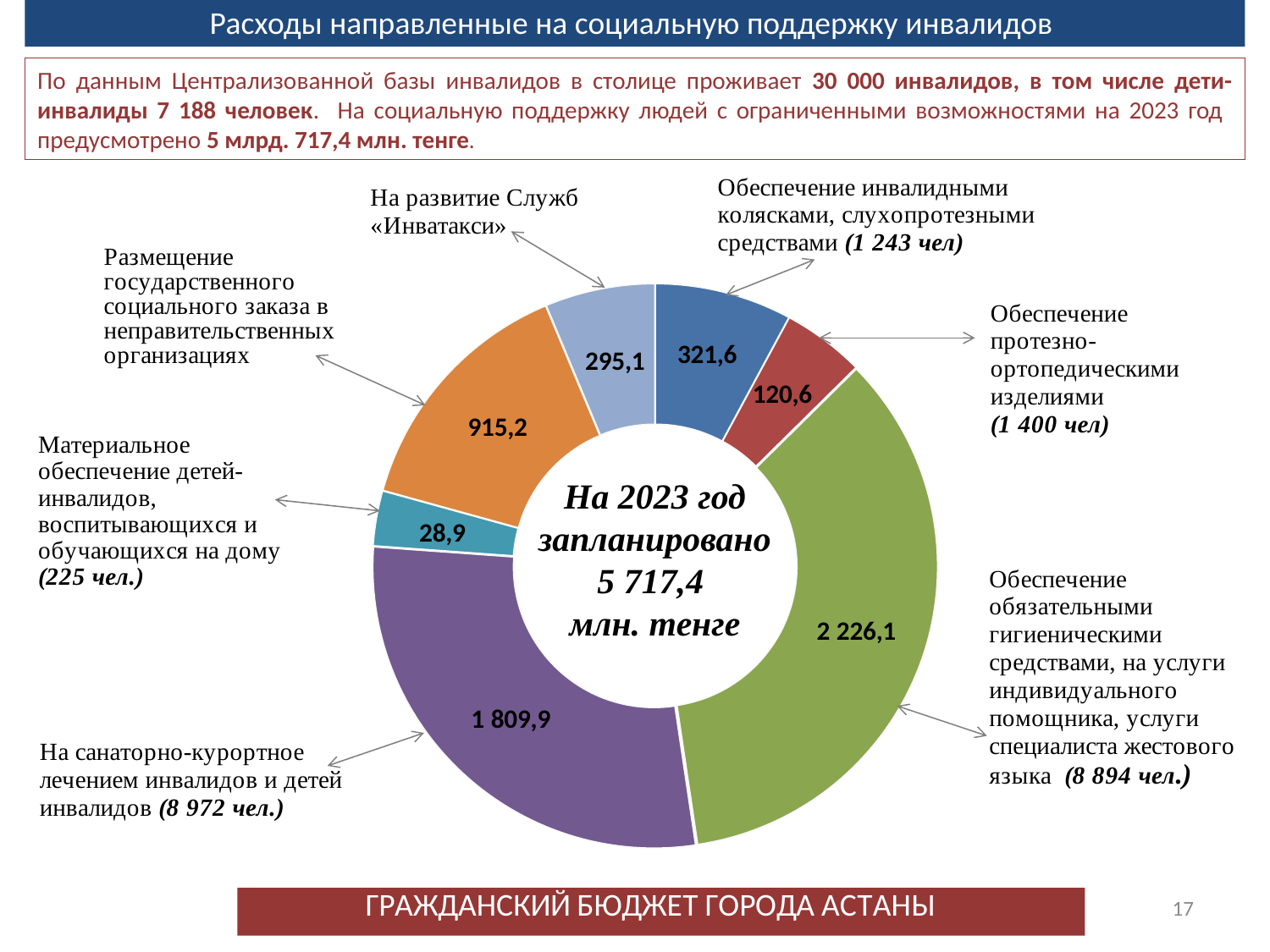
What value is shown for the segment 'На развитие Служб «Инватакси»'? 295,1 What is the difference between the largest segment (2 226,1) and the segment for 'На санаторно-курортное лечением инвалидов и детей инвалидов' (1 809,9)? 416,2 Which segment of the chart has the smallest value? Материальное обеспечение детей-инвалидов, воспитывающихся и обучающихся на дому (28,9) What is the difference between 'Размещение государственного социального заказа в неправительственных организациях' (915,2) and 'На развитие Служб «Инватакси»' (295,1)? 620,1 What total amount is shown in the centre of the donut chart for 2023? 5 717,4 млн. тенге What type of chart is shown on the slide? Donut (pie) chart What value is shown for 'Материальное обеспечение детей-инвалидов, воспитывающихся и обучающихся на дому'? 28,9 Which segment of the chart has the largest value? Обеспечение обязательными гигиеническими средствами, на услуги индивидуального помощника, услуги специалиста жестового языка (2 226,1) How many segments does the donut chart have? 7 What value is shown for 'Обеспечение протезно-ортопедическими изделиями'? 120,6 What value is shown for 'Обеспечение инвалидными колясками, слухопротезными средствами'? 321,6 Which is larger: the value for 'Обеспечение инвалидными колясками, слухопротезными средствами' or for 'Обеспечение протезно-ортопедическими изделиями'? Обеспечение инвалидными колясками, слухопротезными средствами (321,6)